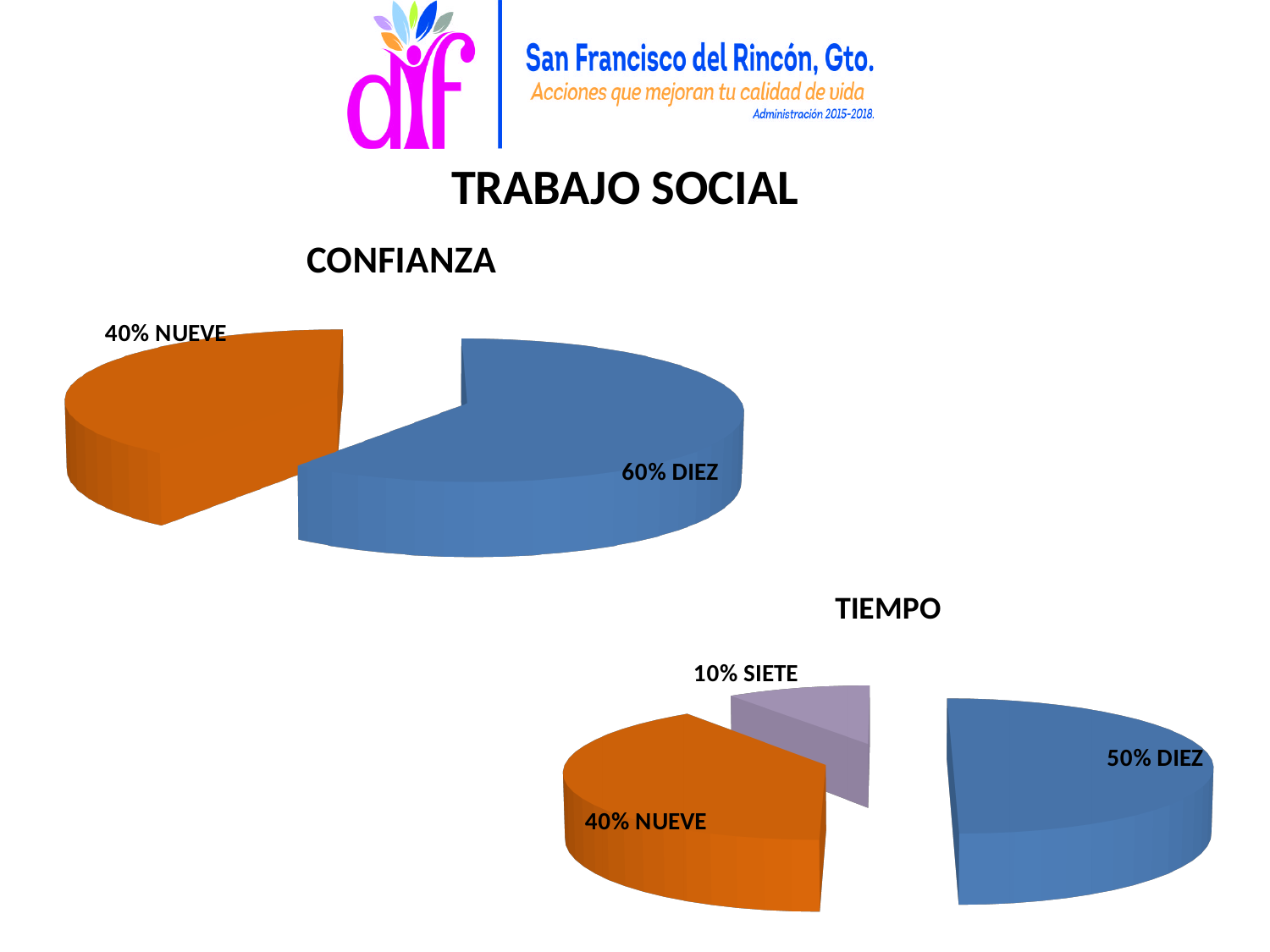
In the CONFIANZA chart, what is the difference in percentage points between the DIEZ and NUEVE slices? 20% In the CONFIANZA chart, which category has the largest slice? DIEZ In the TIEMPO chart, what share of the pie is labelled SIETE? 10% In the CONFIANZA chart, what share of the pie is labelled NUEVE? 40% In the TIEMPO chart, which category has the smallest slice? SIETE In the TIEMPO chart, what share of the pie is labelled DIEZ? 50% What kind of chart is the CONFIANZA chart? Pie chart In the CONFIANZA chart, how many slices does the pie have? 2 In the TIEMPO chart, how many slices does the pie have? 3 In the TIEMPO chart, what colour is the DIEZ slice? Blue In the TIEMPO chart, which slice is larger, NUEVE or SIETE? NUEVE